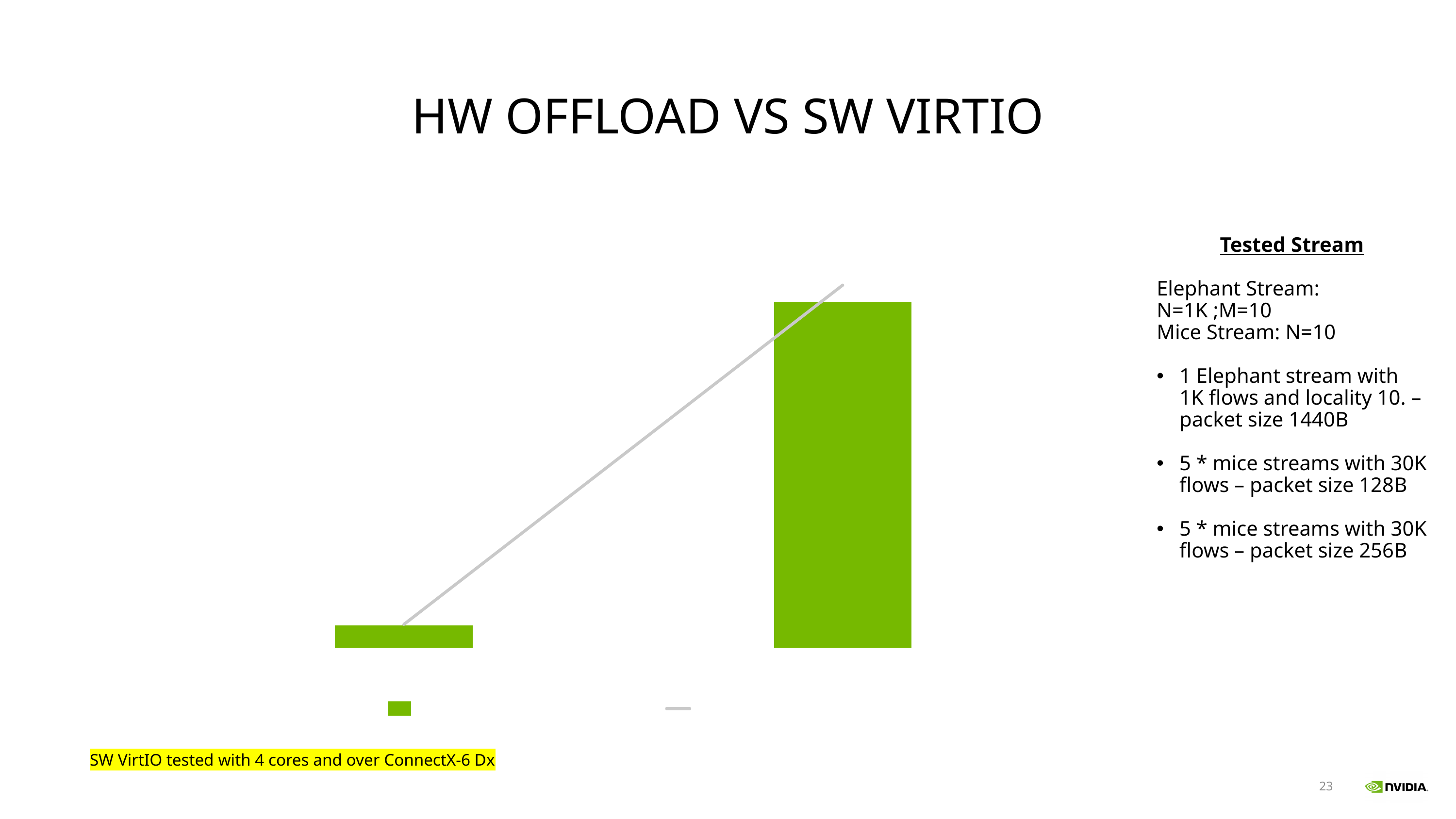
What colour are the bars in the chart? green How many entries does the legend below the chart show? 2 Which bar is taller, the left bar or the right bar? the right bar Does the grey line rise or fall from left to right? rises Which bar is the lowest in the chart? the left bar How many bars are plotted in the chart? 2 What kind of chart is shown on the slide? bar chart with a line